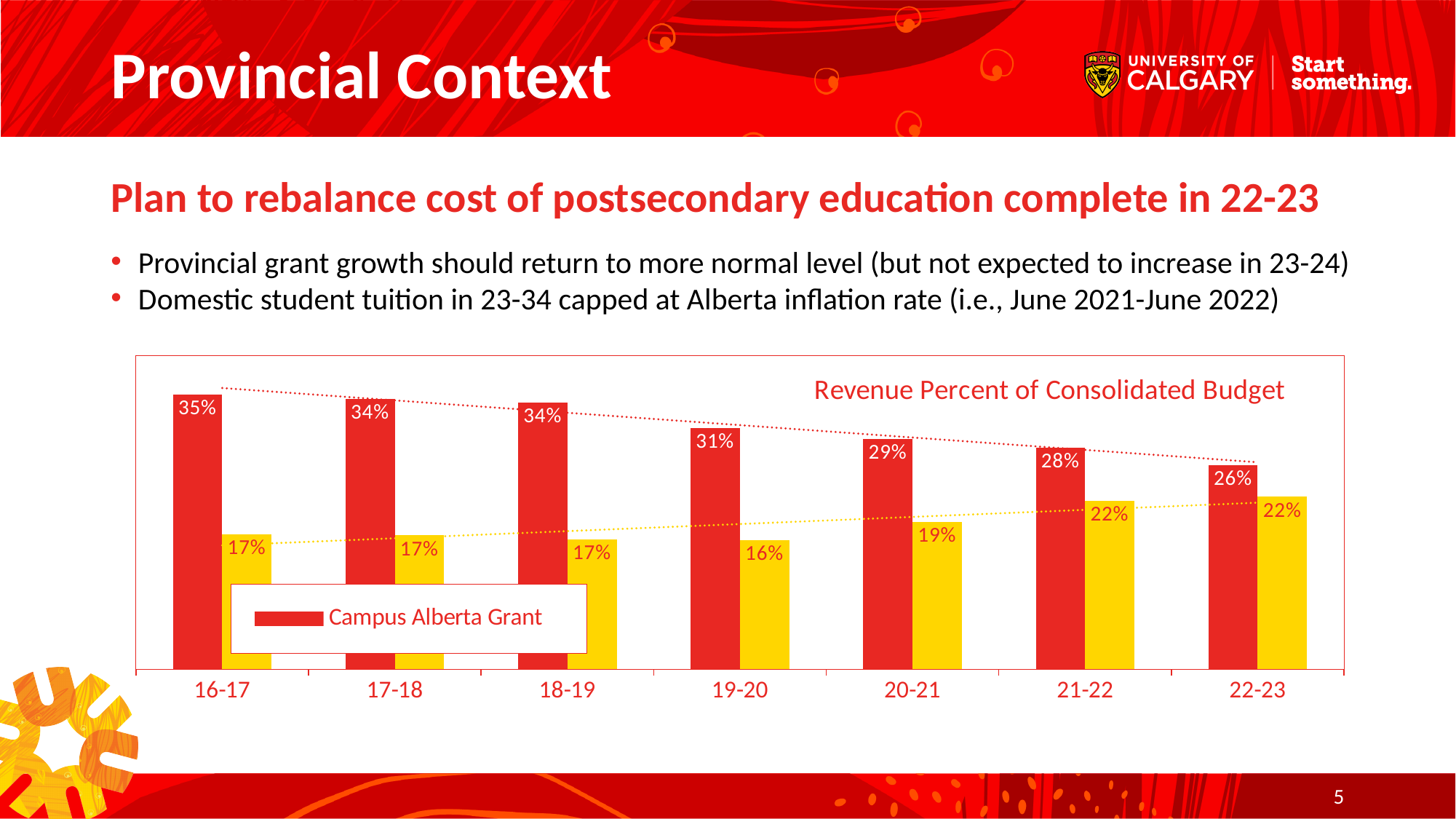
What is the value of the yellow bar for 19-20? 16% What is the difference between the Campus Alberta Grant values for 16-17 and 22-23? 9% Which is larger in 21-22: the Campus Alberta Grant bar or the yellow bar? Campus Alberta Grant What is the title of the chart? Revenue Percent of Consolidated Budget What is the value of the yellow bar for 20-21? 19% In which year is the yellow bar lowest? 19-20 In which year is the Campus Alberta Grant value highest? 16-17 Do the Campus Alberta Grant values rise or fall from 16-17 to 22-23? Fall What is the Campus Alberta Grant value for 22-23? 26% How many years are shown on the x axis? 7 What is the Campus Alberta Grant value for 16-17? 35% What kind of chart is shown? Bar chart